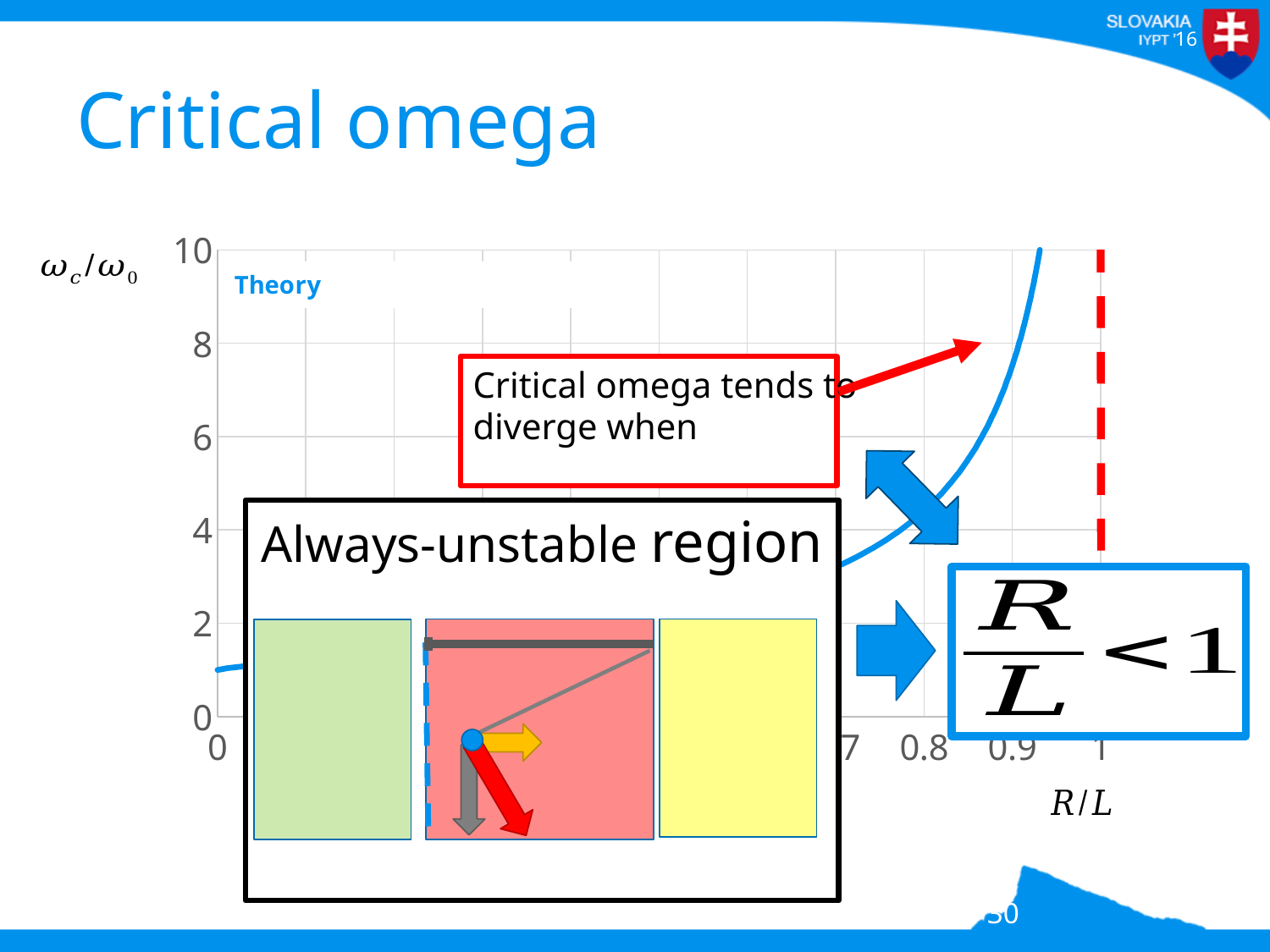
Is the value of the Theory curve at R/L = 0.9 greater or less than 4? greater At which R/L value is the vertical dashed red line drawn on the chart? 1 What kind of chart is shown on the slide? line chart What is the highest tick value shown on the y axis of the chart? 10 What quantity is plotted on the x axis of the chart? R/L Does the Theory curve rise or fall as R/L increases toward 1? rise Is the value of the Theory curve near R/L = 0 greater or less than 2? less